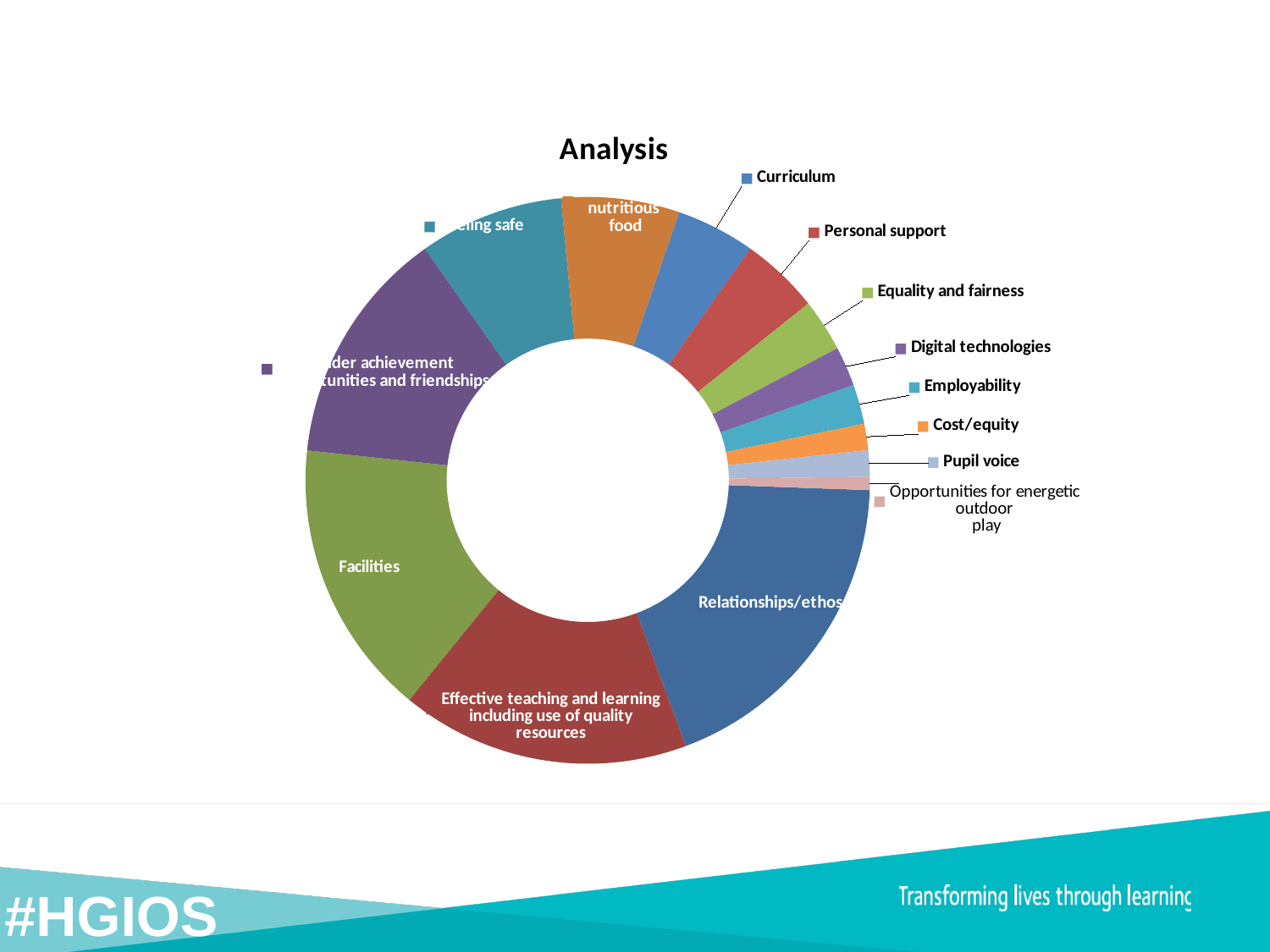
What is the title of the chart? Analysis Which slice is larger, Pupil voice or Relationships/ethos? Relationships/ethos Which slice is larger, Facilities or Curriculum? Facilities How many categories (slices) does the chart contain? 14 What colour is the Facilities slice? Green What kind of chart is shown on the slide? Doughnut (pie) chart Which category has the largest slice in the chart? Relationships/ethos Which slice is larger, Personal support or Employability? Personal support Which category has the smallest slice in the chart? Opportunities for energetic outdoor play